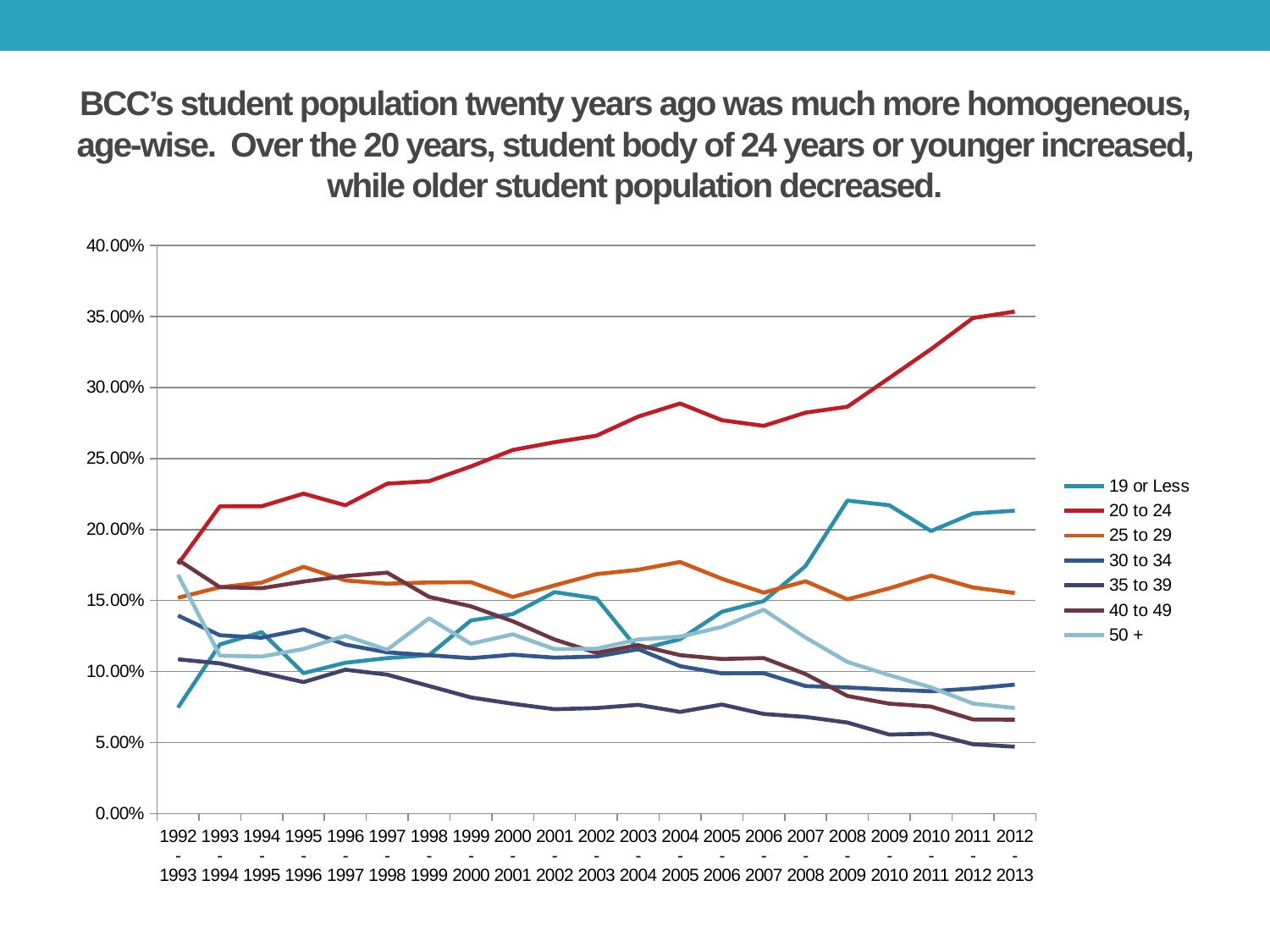
What colour is the line for the 20 to 24 series? red What kind of chart is shown on the slide? line chart Does the 35 to 39 series generally rise or fall from 1992-1993 to 2012-2013? fall How many academic years are plotted along the x axis? 21 In 2012-2013, which is larger: the value for 20 to 24 or the value for 19 or Less? 20 to 24 Is the value for 20 to 24 in 2012-2013 greater or less than 30.00%? greater Which age group has the lowest value in 1992-1993? 19 or Less How many series does the legend list? 7 Is the value for 25 to 29 in 2004-2005 greater or less than 15.00%? greater Is the value for 19 or Less in 1992-1993 greater or less than 10.00%? less Does the 20 to 24 series generally rise or fall from 1992-1993 to 2012-2013? rise Which age group has the highest value in 2012-2013? 20 to 24